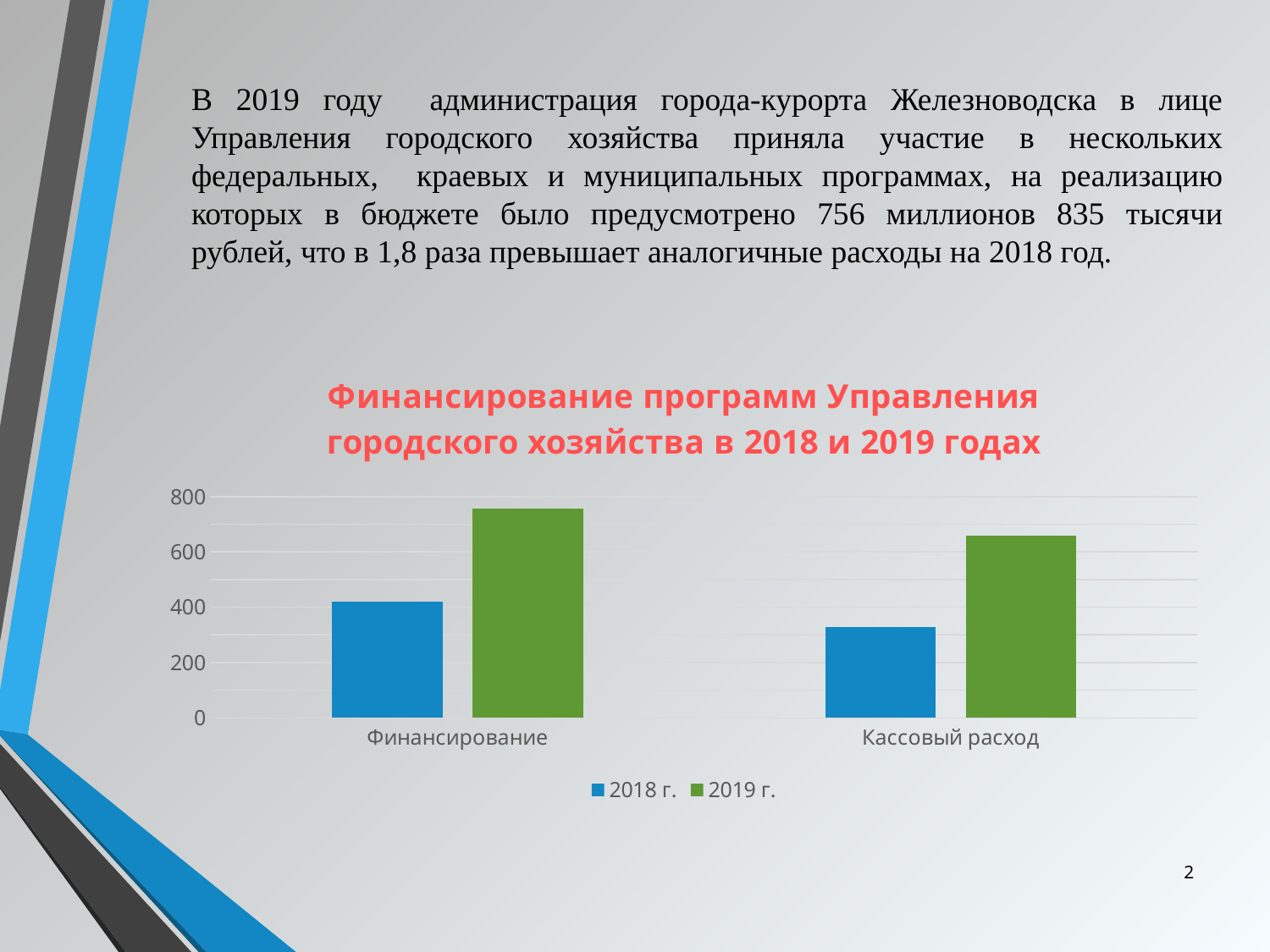
What is the title of the chart? Финансирование программ Управления городского хозяйства в 2018 и 2019 годах Is the value for 2018 г. in the Кассовый расход category greater or less than 400? less Which bar in the chart is the tallest? 2019 г. in Финансирование How many categories are shown on the x axis of the chart? 2 Is the value for 2019 г. in the Кассовый расход category greater or less than 600? greater What kind of chart is shown on the slide? Bar chart Is the value for 2018 г. in the Финансирование category greater or less than 600? less How many series does the chart legend list? 2 Which category has the higher value for the 2018 г. series, Финансирование or Кассовый расход? Финансирование Which colour represents the 2019 г. series in the chart? Green Which series has the higher value in the Финансирование category, 2018 г. or 2019 г.? 2019 г.